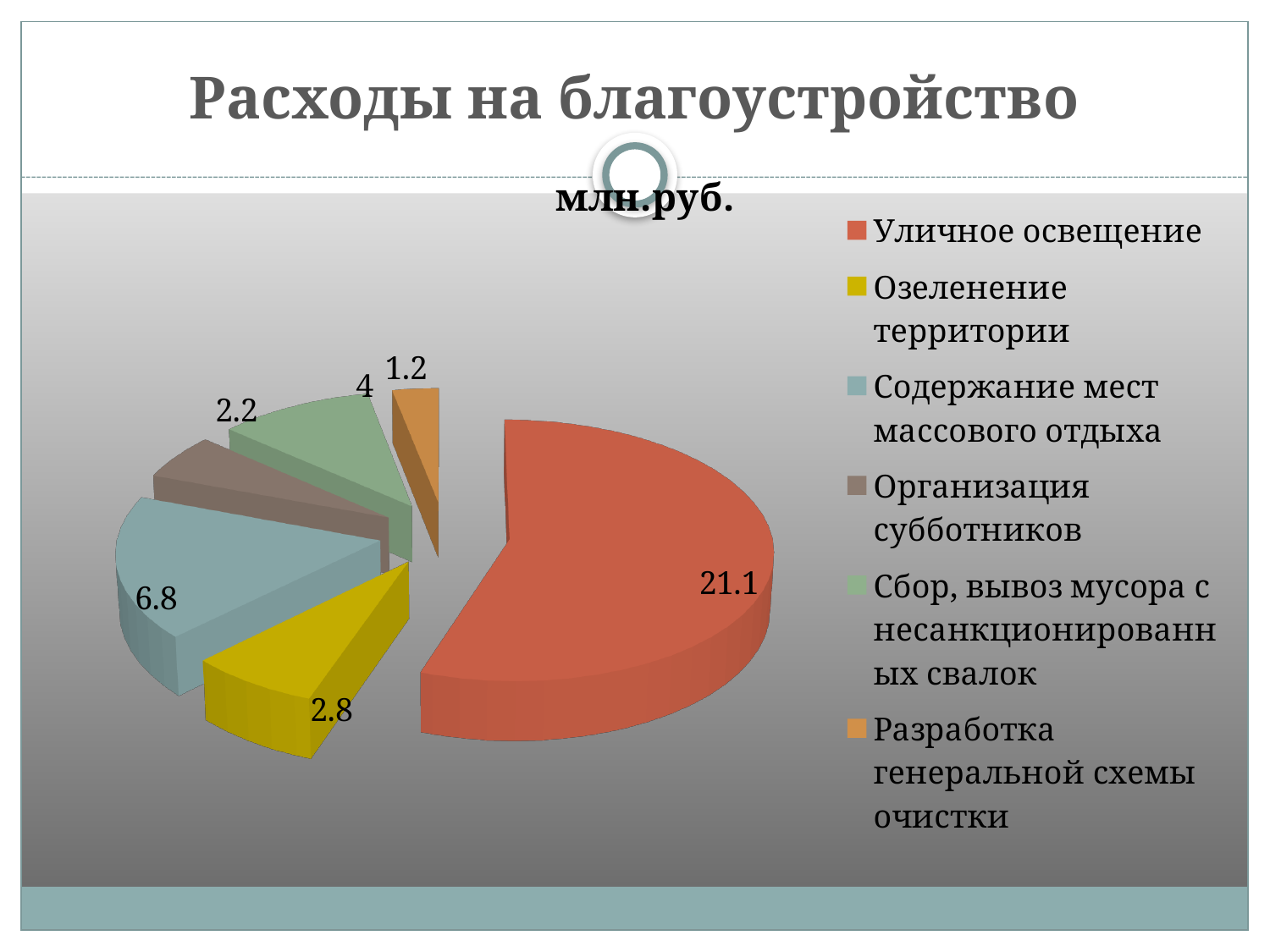
Which category has the largest slice of the pie? Уличное освещение What is the value for Уличное освещение? 21.1 What unit is given in the chart title? млн.руб. Which is larger: Озеленение территории or Сбор, вывоз мусора с несанкционированных свалок? Сбор, вывоз мусора с несанкционированных свалок What is the difference between the values for Озеленение территории and Организация субботников? 0.6 What is the value for Разработка генеральной схемы очистки? 1.2 How many categories does the pie chart show? 6 What is the value for Сбор, вывоз мусора с несанкционированных свалок? 4 What is the value for Содержание мест массового отдыха? 6.8 What kind of chart is shown on the slide? Pie chart Which category has the smallest slice of the pie? Разработка генеральной схемы очистки What is the difference between the values for Уличное освещение and Содержание мест массового отдыха? 14.3